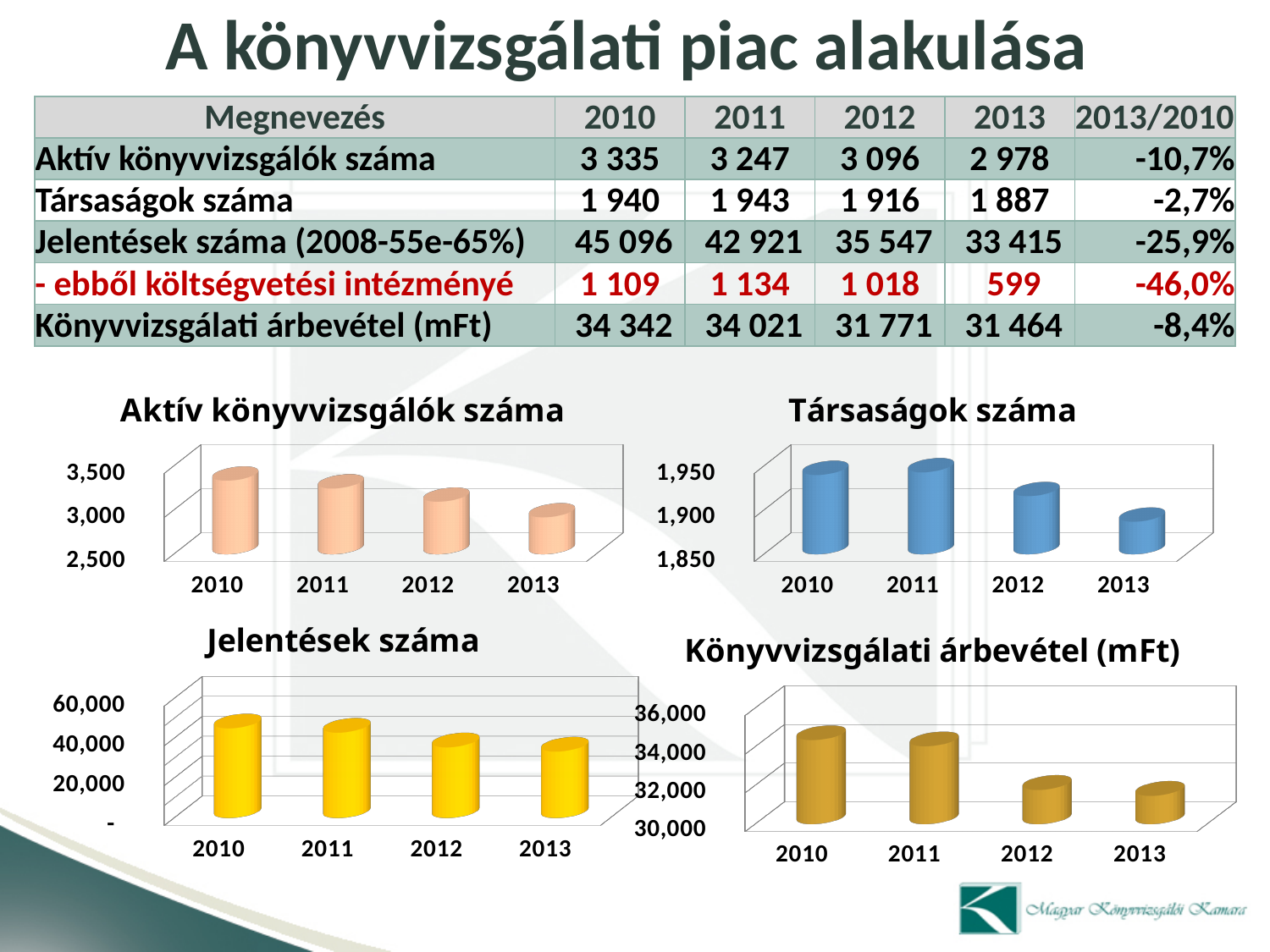
In the "Jelentések száma" chart, which year has the highest value? 2010 In the "Jelentések száma" chart, is the value for 2013 greater or less than 40,000? less In the "Könyvvizsgálati árbevétel (mFt)" chart, is the value for 2013 greater or less than 34,000? less In the "Aktív könyvvizsgálók száma" chart, is the value for 2010 greater or less than 3,000? greater What kind of chart is the "Aktív könyvvizsgálók száma" chart? bar chart According to the table, what is the difference between the "Jelentések száma" values for 2010 and 2013? 11 681 In the "Jelentések száma" chart, do the values rise or fall from 2010 to 2013? fall In the "Könyvvizsgálati árbevétel (mFt)" chart, which year has the lowest value? 2013 What colour are the bars in the "Társaságok száma" chart? blue According to the table, what is the value of "Aktív könyvvizsgálók száma" for 2013? 2 978 How many years are plotted in the "Társaságok száma" chart? 4